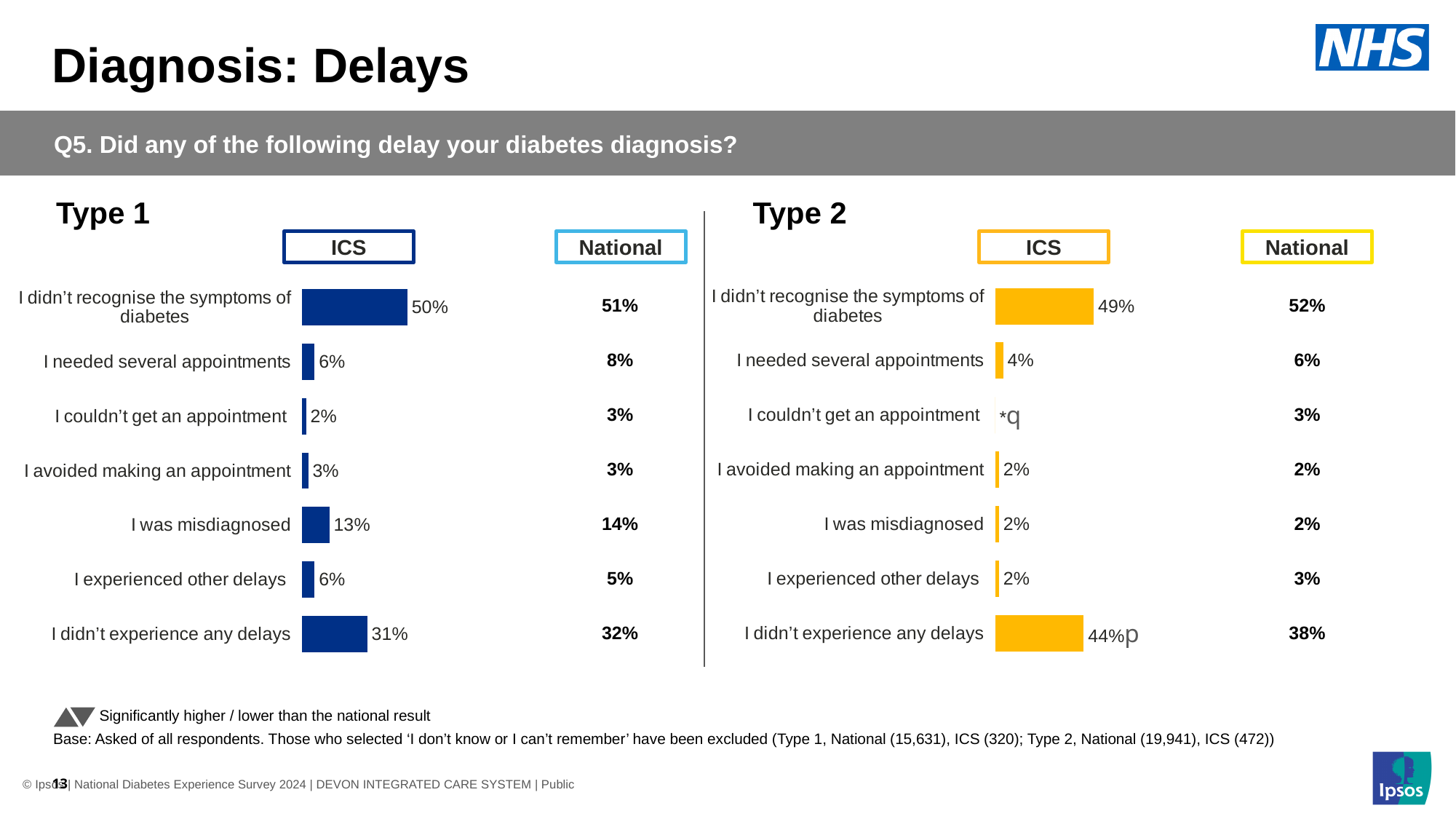
In the Type 2 chart, what is the ICS value for 'I didn't experience any delays'? 44% In the Type 1 chart, what is the National value for 'I was misdiagnosed'? 14% In the Type 2 chart, what is the National value for 'I needed several appointments'? 6% In the Type 2 chart, which is larger for 'I didn't recognise the symptoms of diabetes': the ICS value or the National value? National How many categories are listed in the Type 1 chart? 7 In the Type 1 chart, which category has the lowest ICS value? I couldn't get an appointment What colour are the ICS bars in the Type 2 chart? Yellow In the Type 1 chart, what is the ICS value for 'I didn't recognise the symptoms of diabetes'? 50% In the Type 1 chart, what is the difference between the ICS values for 'I didn't recognise the symptoms of diabetes' and 'I didn't experience any delays'? 19% What kind of chart is used to show the ICS values in the Type 1 chart? Bar chart In the Type 2 chart, what is the difference between the ICS and National values for 'I didn't experience any delays'? 6% In the Type 1 chart, which category has the highest ICS value? I didn't recognise the symptoms of diabetes